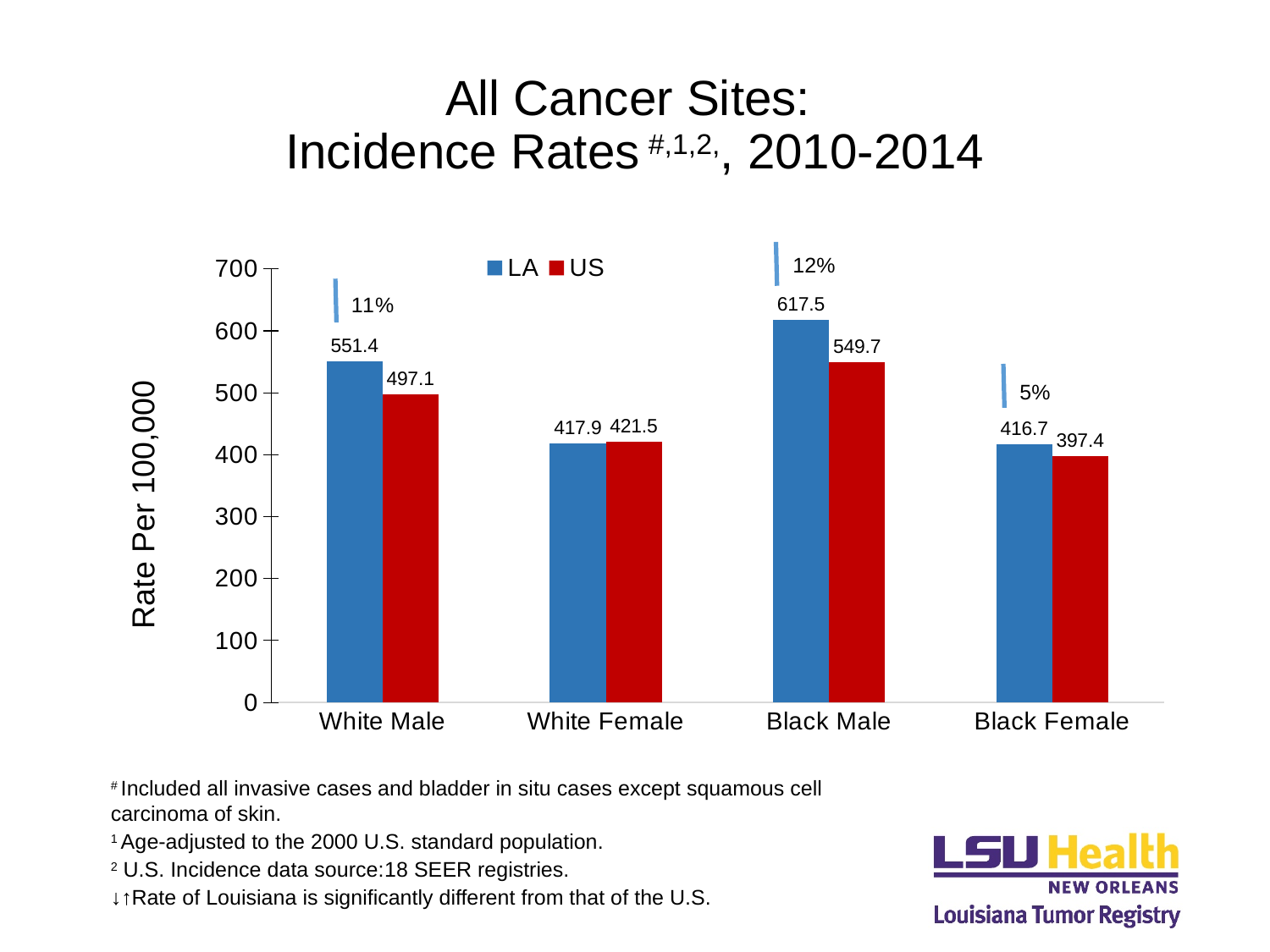
What is the y-axis label of the chart? Rate Per 100,000 Is the LA rate for Black Male greater or less than 600? greater Which category has the highest LA incidence rate? Black Male How many categories are shown on the x axis? 4 Which is larger for White Female, the LA rate or the US rate? US How many series does the legend list? 2 What is the US incidence rate for White Female? 421.5 What kind of chart is shown on the slide? bar chart What is the US incidence rate for Black Female? 397.4 What is the LA incidence rate for White Male? 551.4 What is the difference between the LA and US rates for Black Male? 67.8 Which category has the lowest US incidence rate? Black Female